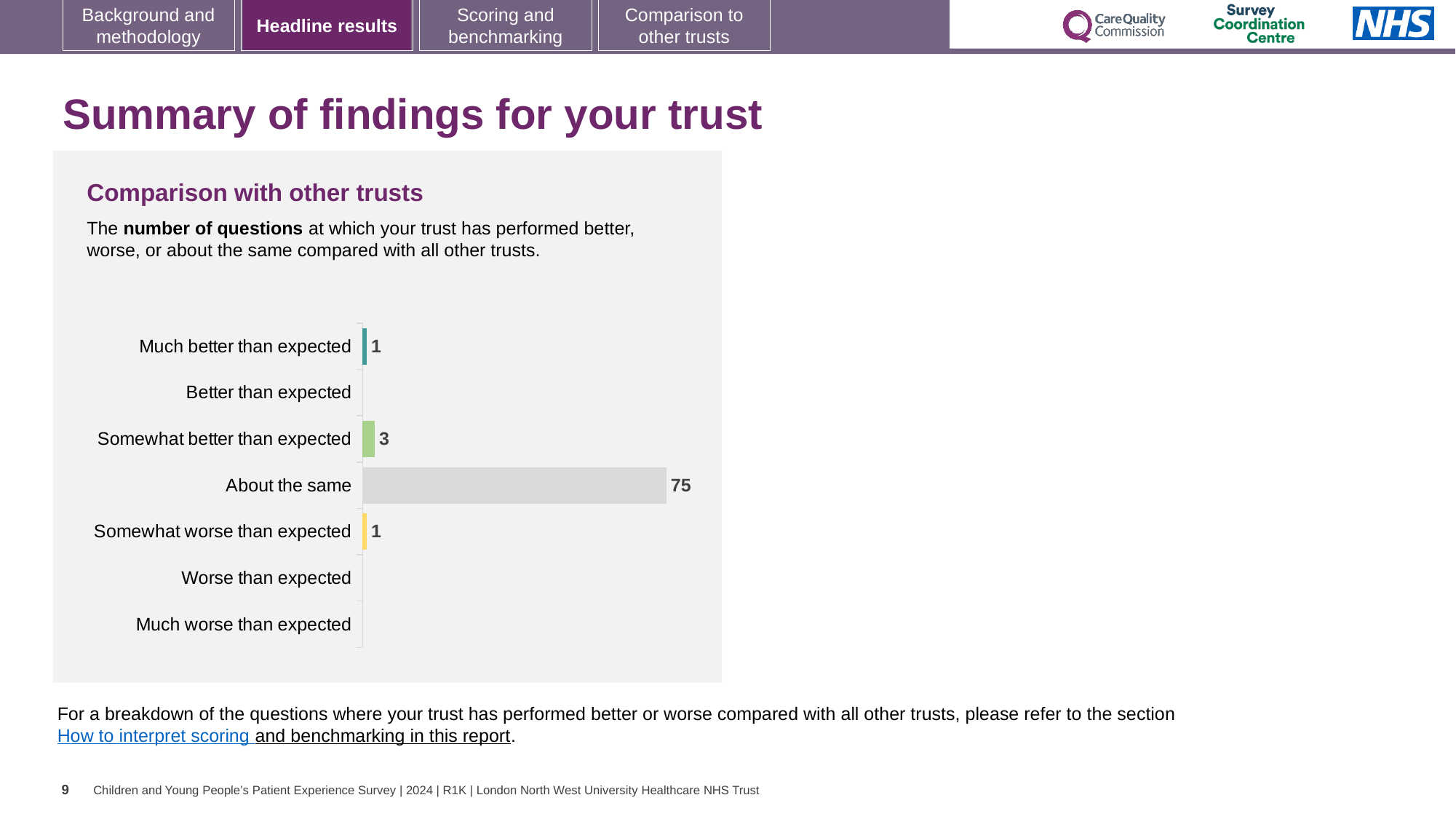
Which category has the highest number of questions? About the same What is the total number of questions across all categories shown? 80 What is the value for 'Somewhat worse than expected'? 1 How many questions were rated 'About the same'? 75 What kind of chart is shown on the slide? Bar chart What is the title of the chart section? Comparison with other trusts What is the difference between 'About the same' and 'Somewhat better than expected'? 72 Which is larger, 'Somewhat better than expected' or 'Somewhat worse than expected'? Somewhat better than expected What is the value for 'Somewhat better than expected'? 3 What colour is the bar for 'Somewhat worse than expected'? Yellow What is the value for 'Much better than expected'? 1 How many categories are shown on the chart? 7